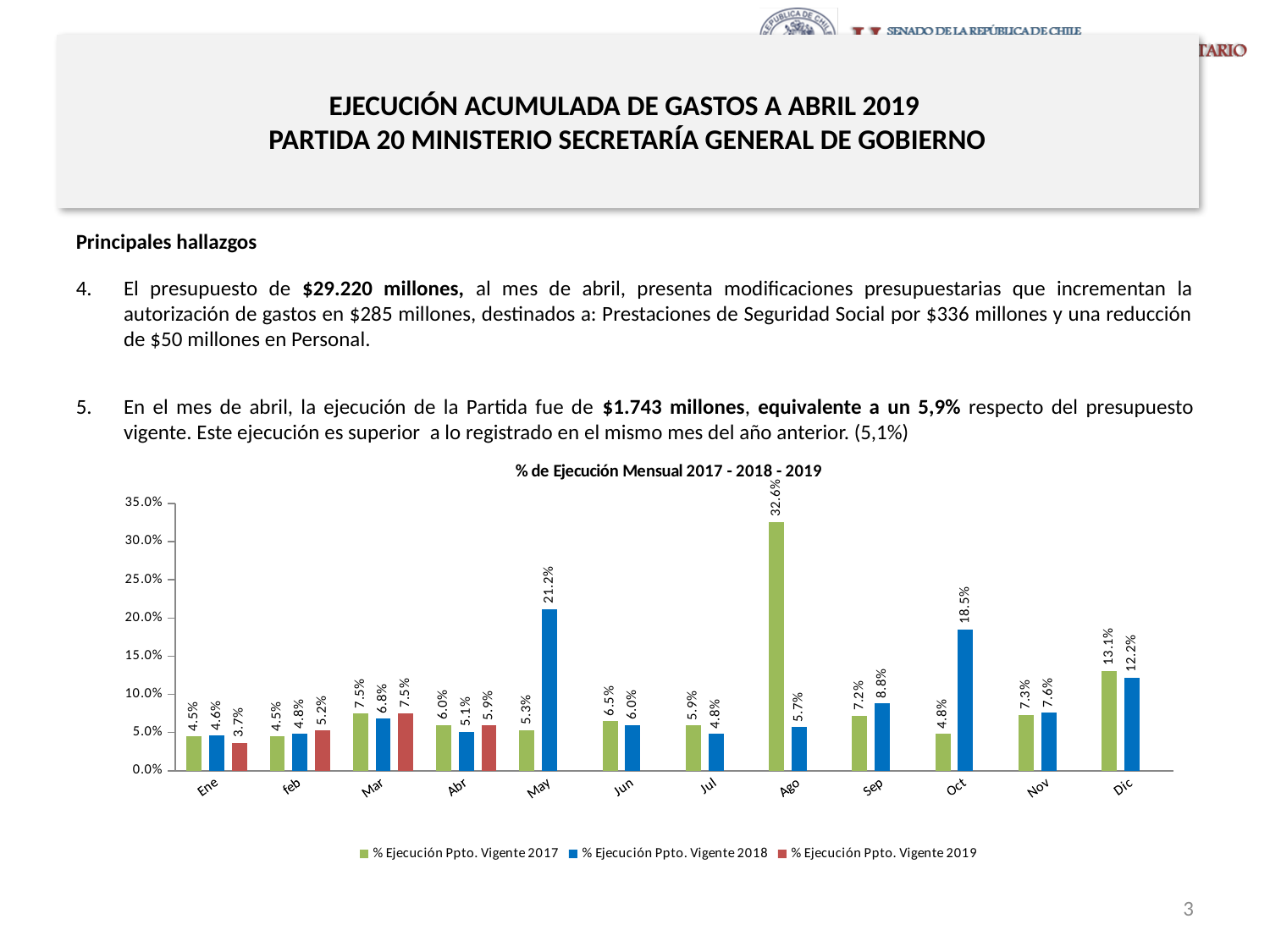
In which month is the % Ejecución Ppto. Vigente 2017 series highest? Ago How many months are shown on the x axis? 12 In which month is the % Ejecución Ppto. Vigente 2019 series lowest? Ene What kind of chart is shown? Bar chart What is the difference between the 2018 and 2017 values in Oct? 13.7% What is the value for % Ejecución Ppto. Vigente 2017 in Dic? 13.1% Which is larger in Sep: the 2017 value or the 2018 value? 2018 (8.8%) What is the value for % Ejecución Ppto. Vigente 2018 in May? 21.2% What is the value for % Ejecución Ppto. Vigente 2019 in Abr? 5.9% Is the value for % Ejecución Ppto. Vigente 2017 in Ago greater or less than 30.0%? greater What is the title of the chart? % de Ejecución Mensual 2017 - 2018 - 2019 How many series does the legend list? 3